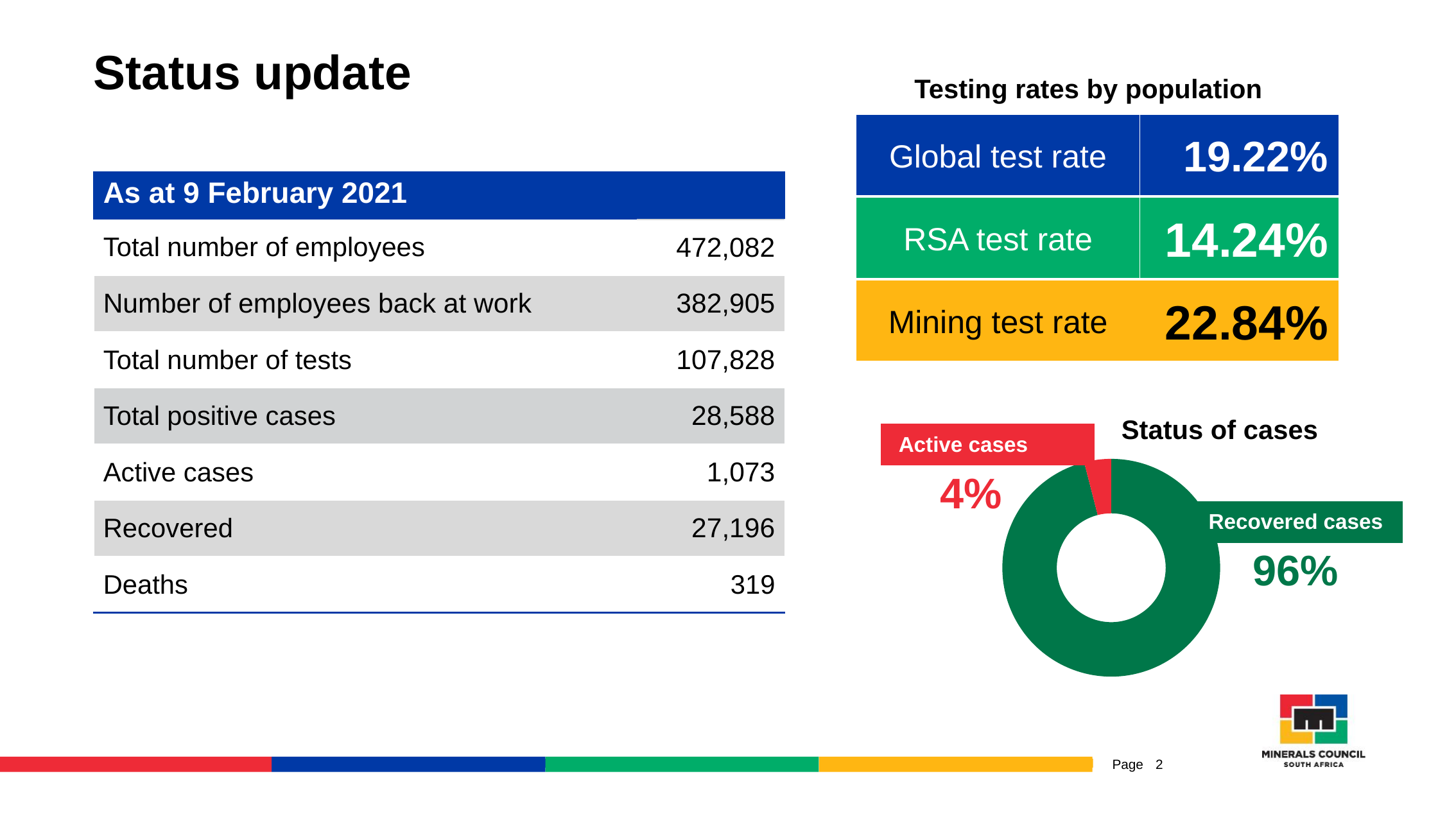
In the "Status of cases" chart, which is larger: the Active cases slice or the Recovered cases slice? Recovered cases In the "Status of cases" chart, which category has the smallest slice? Active cases In the "Status of cases" chart, what share of cases is shown as Recovered cases? 96% In the "Status of cases" chart, is the share for Recovered cases greater or less than 50%? greater In the "Status of cases" chart, which category has the largest slice? Recovered cases In the "Status of cases" chart, what colour is the Active cases slice? Red In the "Status of cases" chart, what share of cases is shown as Active cases? 4% What is the title of the donut chart on the slide? Status of cases In the "Status of cases" chart, how many categories are plotted? 2 In the "Status of cases" chart, what is the difference in percentage points between Recovered cases and Active cases? 92 percentage points What kind of chart is the "Status of cases" chart? Pie chart (donut)